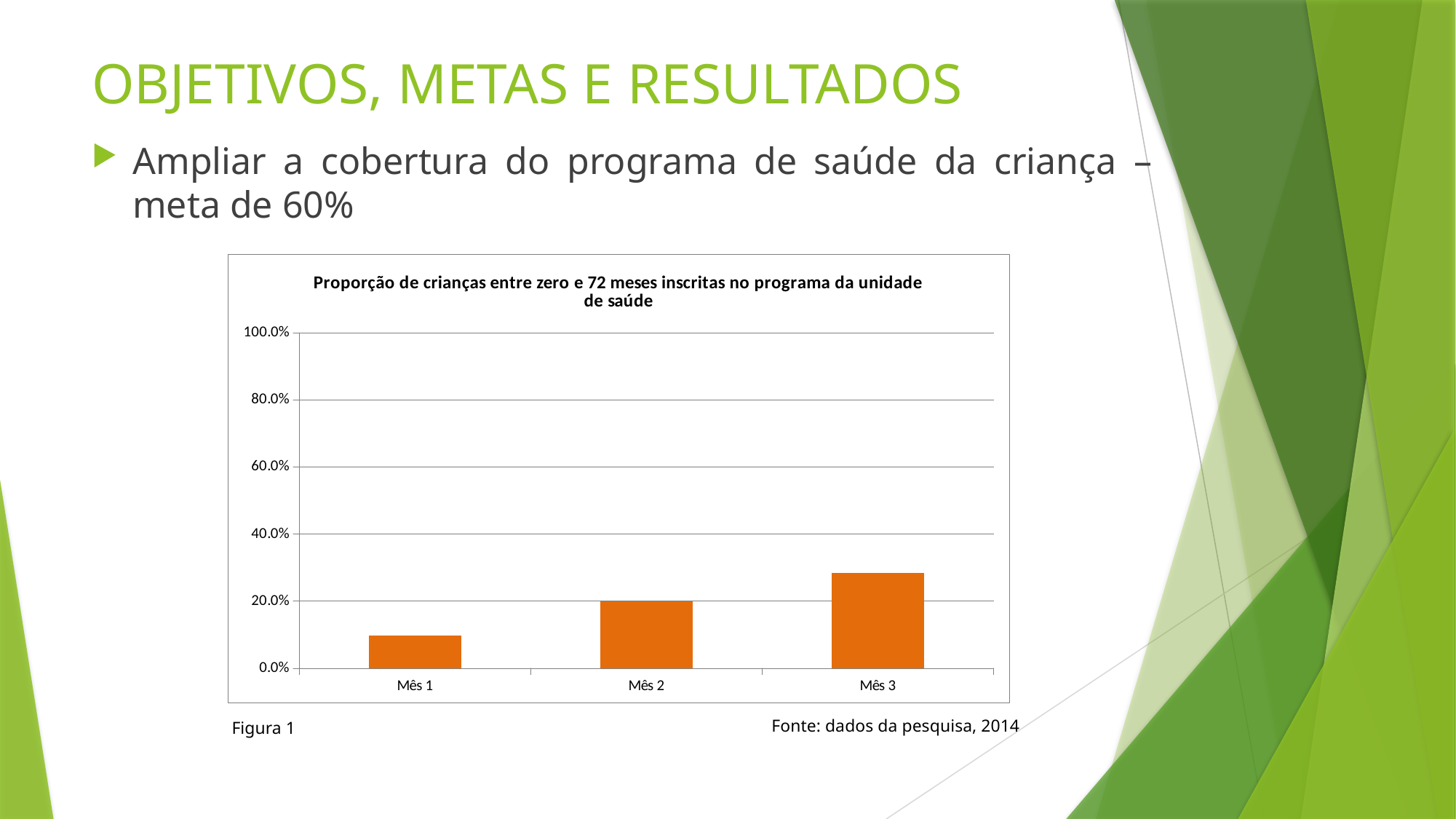
Is the value for Mês 1 greater or less than 20.0%? less Do the values rise or fall from Mês 1 to Mês 3? rise Is the value for Mês 1 greater or less than 60.0%? less Is the value for Mês 3 greater or less than 20.0%? greater What kind of chart is shown on the slide? bar chart What is the title of the chart? Proporção de crianças entre zero e 72 meses inscritas no programa da unidade de saúde How many categories (months) are plotted on the x axis of the chart? 3 Which month has the lowest proportion of children enrolled in the programme? Mês 1 Which month has the highest proportion of children enrolled in the programme? Mês 3 What colour are the bars in the chart? orange Which is larger, the value for Mês 3 or the value for Mês 1? Mês 3